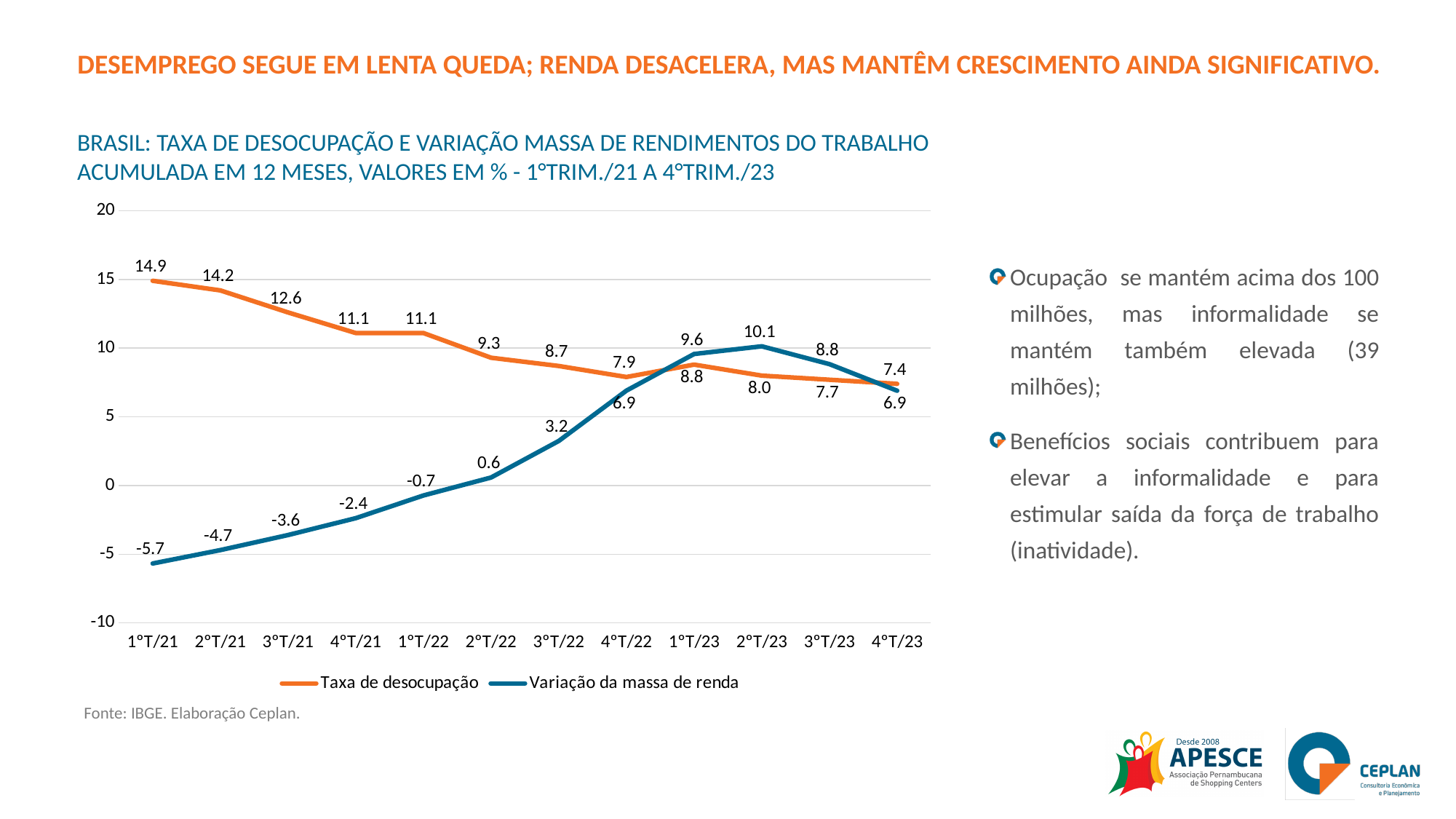
Which colour is used for the Variação da massa de renda line? blue How many series does the legend list? 2 In which quarter does Variação da massa de renda reach its highest value? 2°T/23 In which quarter is Taxa de desocupação lowest? 4°T/23 What is the value of Variação da massa de renda in 2°T/23? 10.1 What type of chart is shown on the slide? line chart What is the value of Variação da massa de renda in 1°T/21? -5.7 Does Taxa de desocupação generally rise or fall from 1°T/21 to 4°T/23? fall In 1°T/23, which series has the higher value, Taxa de desocupação or Variação da massa de renda? Variação da massa de renda What is the difference between Taxa de desocupação in 1°T/21 and in 4°T/23? 7.5 What is the value of Taxa de desocupação in 1°T/21? 14.9 How many quarters are plotted along the x axis? 12